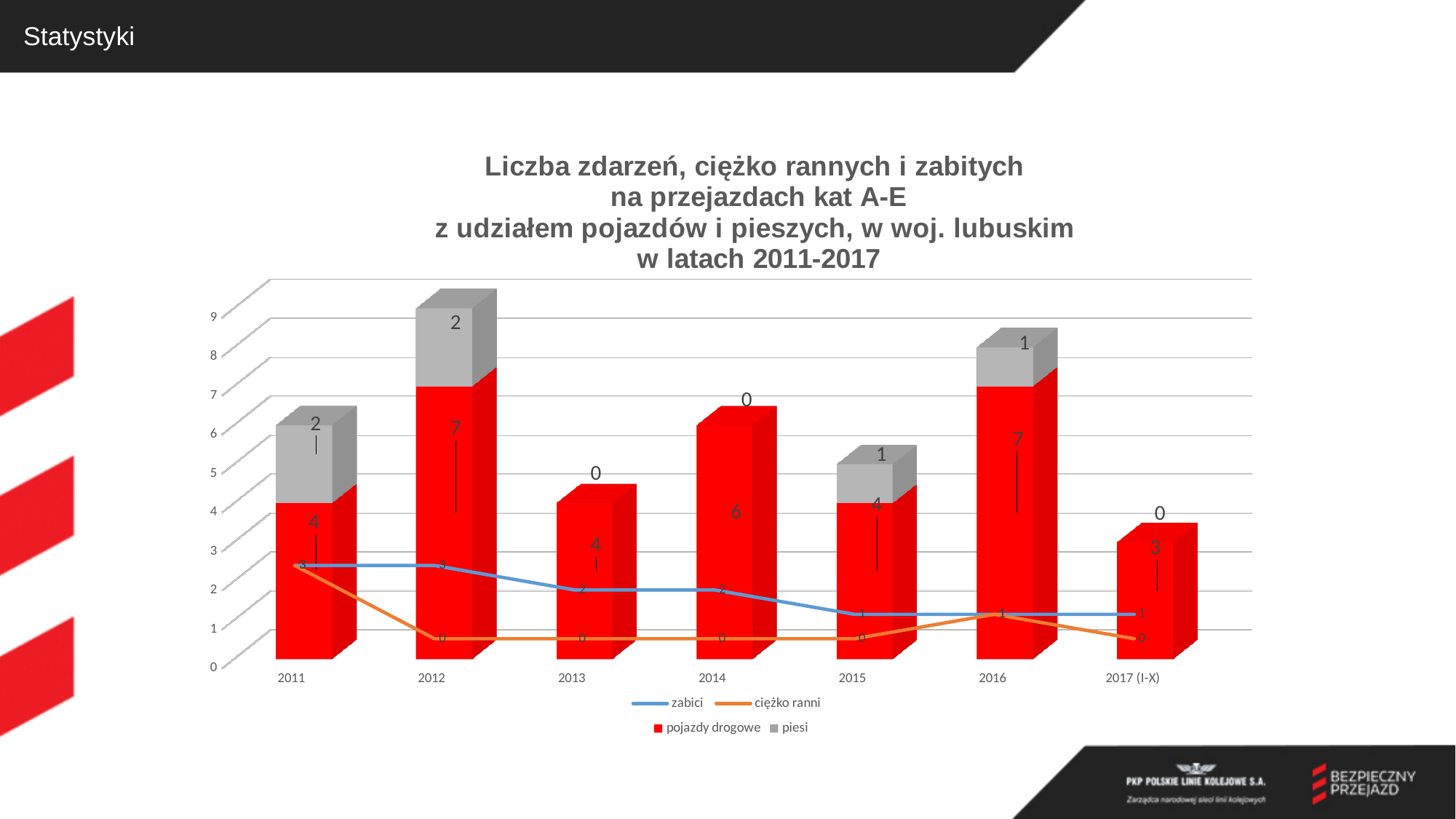
What is the difference between the pojazdy drogowe values for 2012 and 2017 (I-X)? 4 Which year has the lowest value for pojazdy drogowe? 2017 (I-X) What is the value for pojazdy drogowe in 2014? 6 How many series does the legend list? 4 How many years are shown on the x axis? 7 Which is larger, the pojazdy drogowe value for 2014 or for 2015? 2014 What is the value of the ciężko ranni series in 2011? 3 Does the zabici line rise or fall from 2011 to 2017 (I-X)? fall Which year has the tallest stacked bar in total? 2012 What is the total of the stacked bar for 2016? 8 What is the value of the zabici series in 2013? 2 What is the value for piesi in 2012? 2